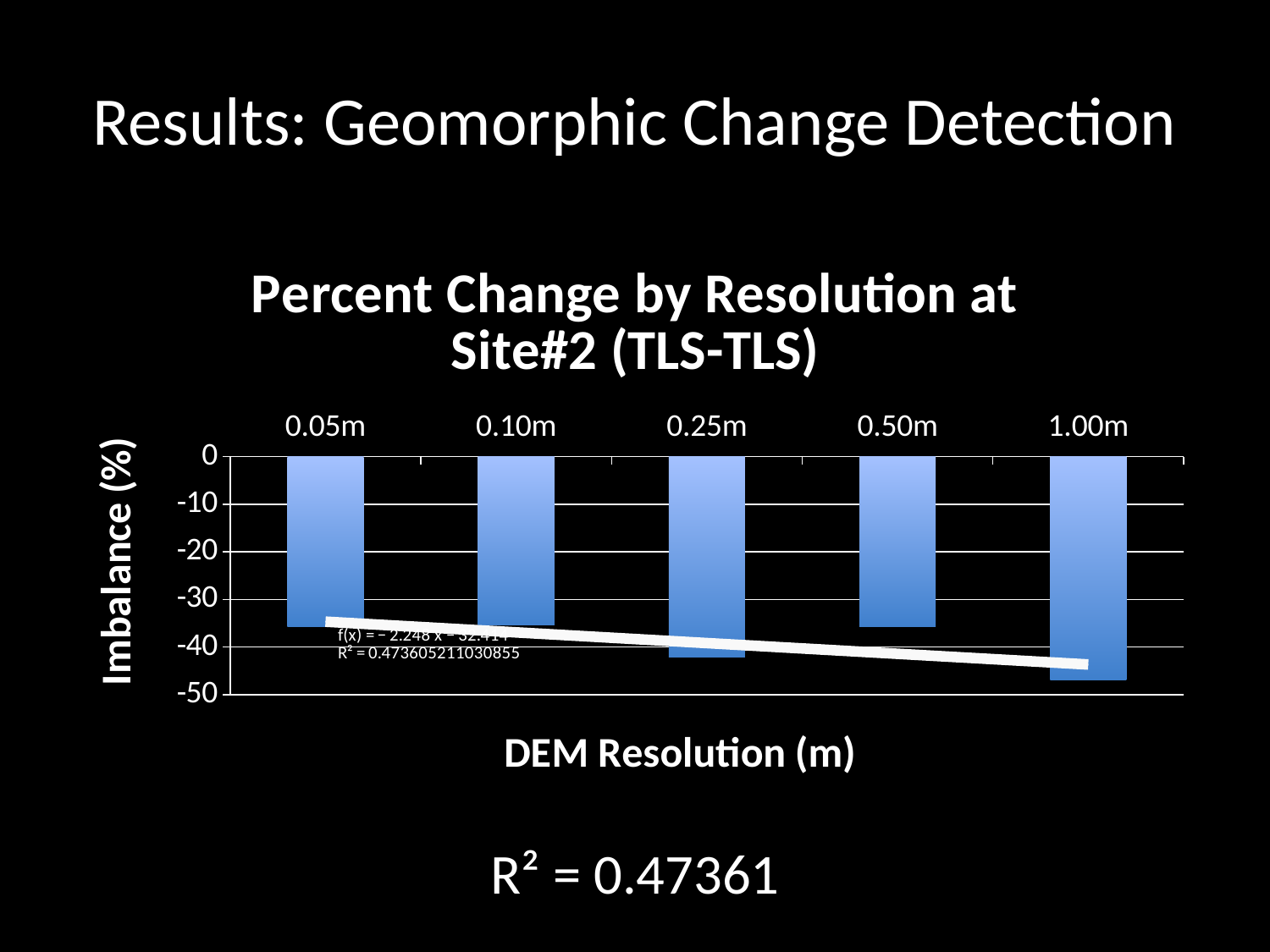
What kind of chart is shown on the slide? bar chart What is the title of the chart? Percent Change by Resolution at Site#2 (TLS-TLS) Is the imbalance value for 1.00m greater or less than -40? less Is the imbalance value for 0.05m greater or less than -40? greater Is the imbalance value for 0.50m greater or less than -40? greater What R² value is printed below the chart? R² = 0.47361 Which has the lower imbalance value, 0.25m or 0.10m? 0.25m What is the label of the vertical axis? Imbalance (%) How many DEM resolution categories are plotted in the chart? 5 Which DEM resolution has the lowest (most negative) imbalance value? 1.00m